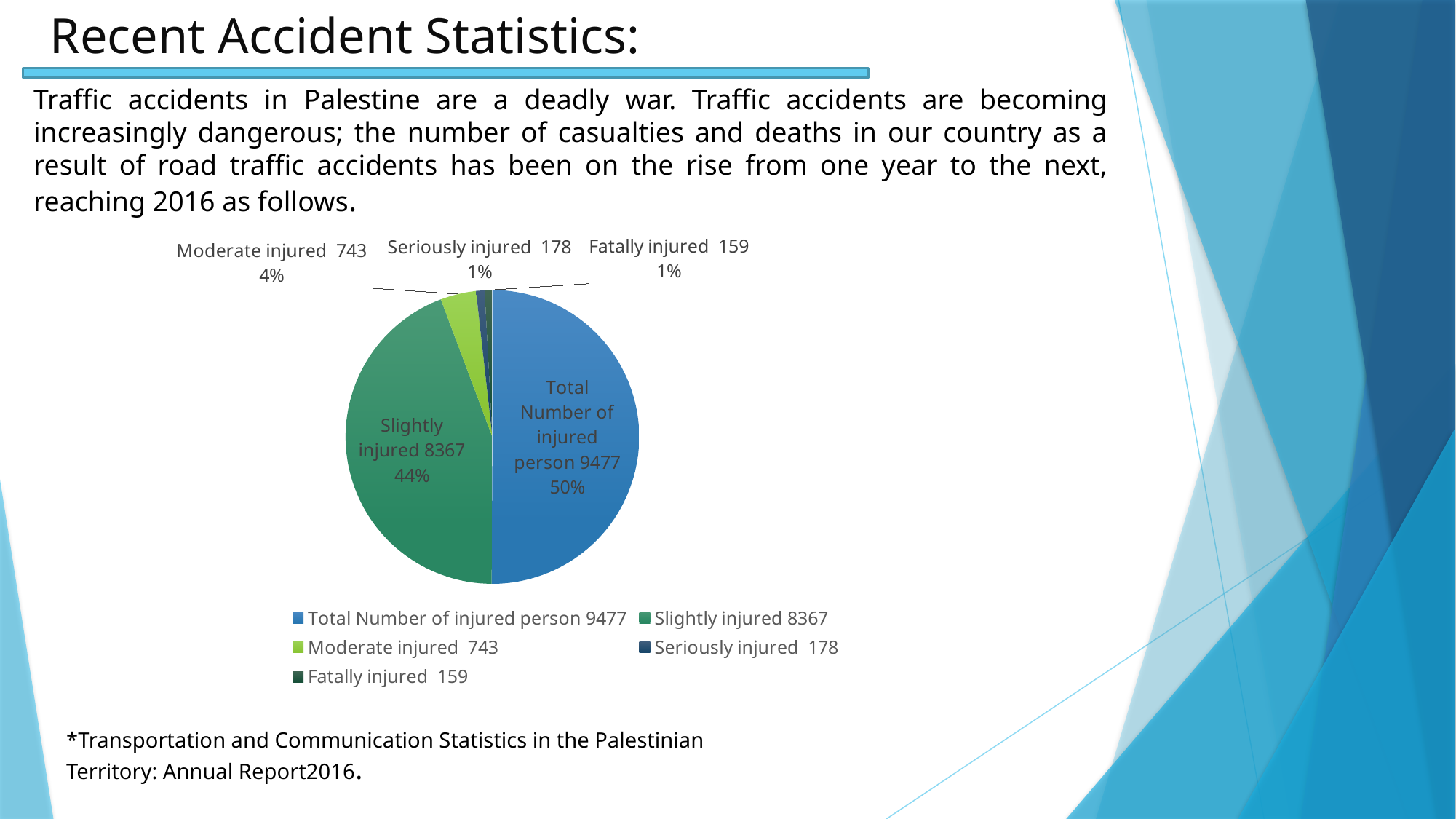
What is the difference between the Slightly injured value and the Moderate injured value? 7624 How many slices does the pie chart have? 5 Which category has the largest slice of the pie? Total Number of injured person 9477 What colour is the Slightly injured slice of the pie? green What is the number of Seriously injured persons shown on the chart? 178 What percentage of the pie does the Total Number of injured person slice represent? 50% What percentage of the pie does the Moderate injured slice represent? 4% What is the number of Fatally injured persons shown on the chart? 159 What percentage of the pie does the Slightly injured slice represent? 44% Which is larger, the Moderate injured value or the Seriously injured value? Moderate injured What kind of chart is shown on the slide? pie chart Which category has the smallest value on the chart? Fatally injured 159